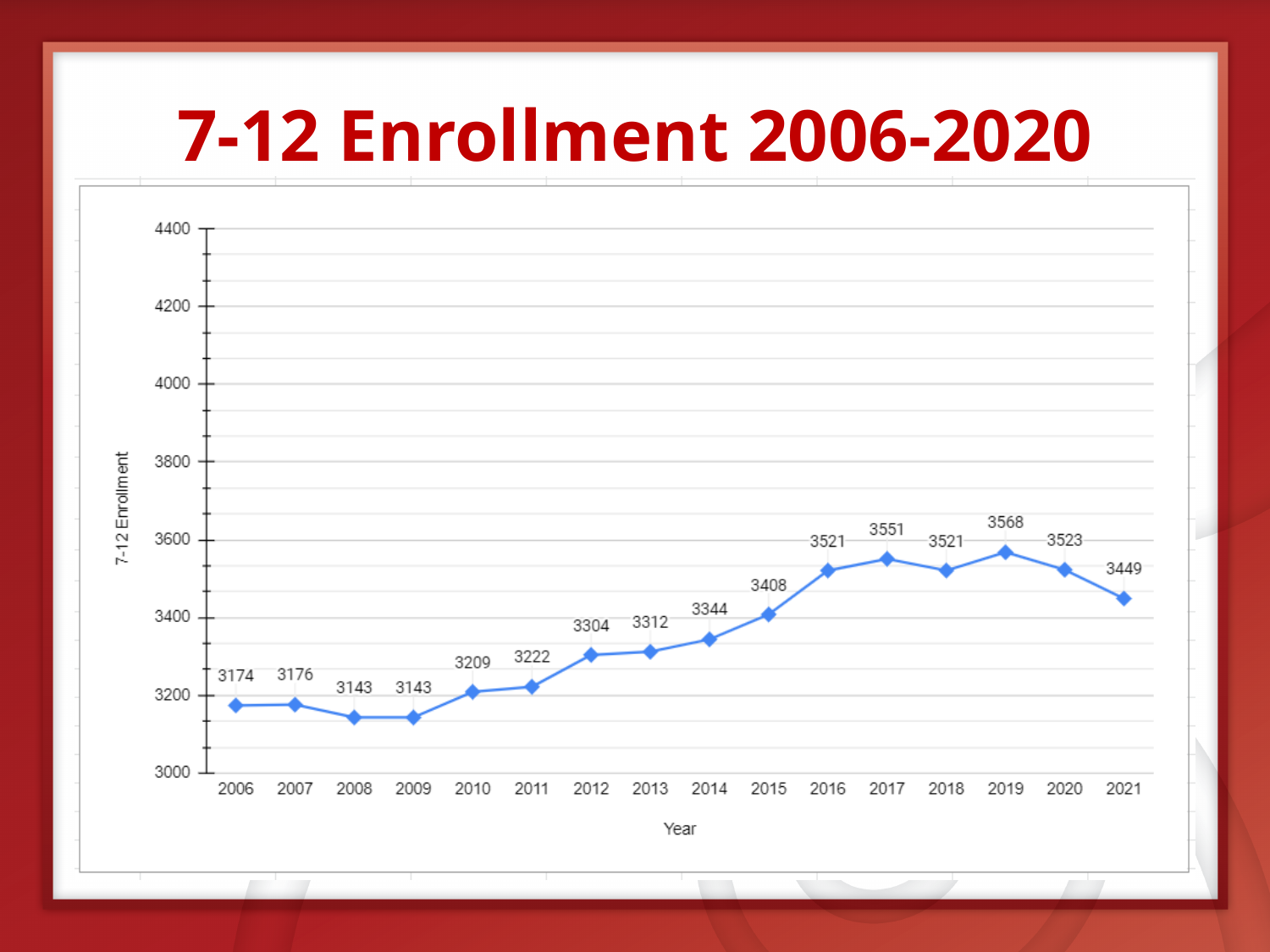
What is the difference between the 7-12 enrollment in 2019 and in 2021? 119 What is the 7-12 enrollment value for 2021? 3449 Do the 7-12 enrollment values rise or fall from 2009 to 2017? rise What kind of chart is shown on the slide? line chart What is the title of the chart on the slide? 7-12 Enrollment 2006-2020 Is the 7-12 enrollment value for 2016 greater or less than 3400? greater How many years are plotted on the x axis of the chart? 16 Which year has a higher 7-12 enrollment, 2015 or 2017? 2017 Which year has the highest 7-12 enrollment? 2019 What is the lowest 7-12 enrollment value shown on the chart? 3143 What is the label of the x axis of the chart? Year What is the 7-12 enrollment value for 2012? 3304